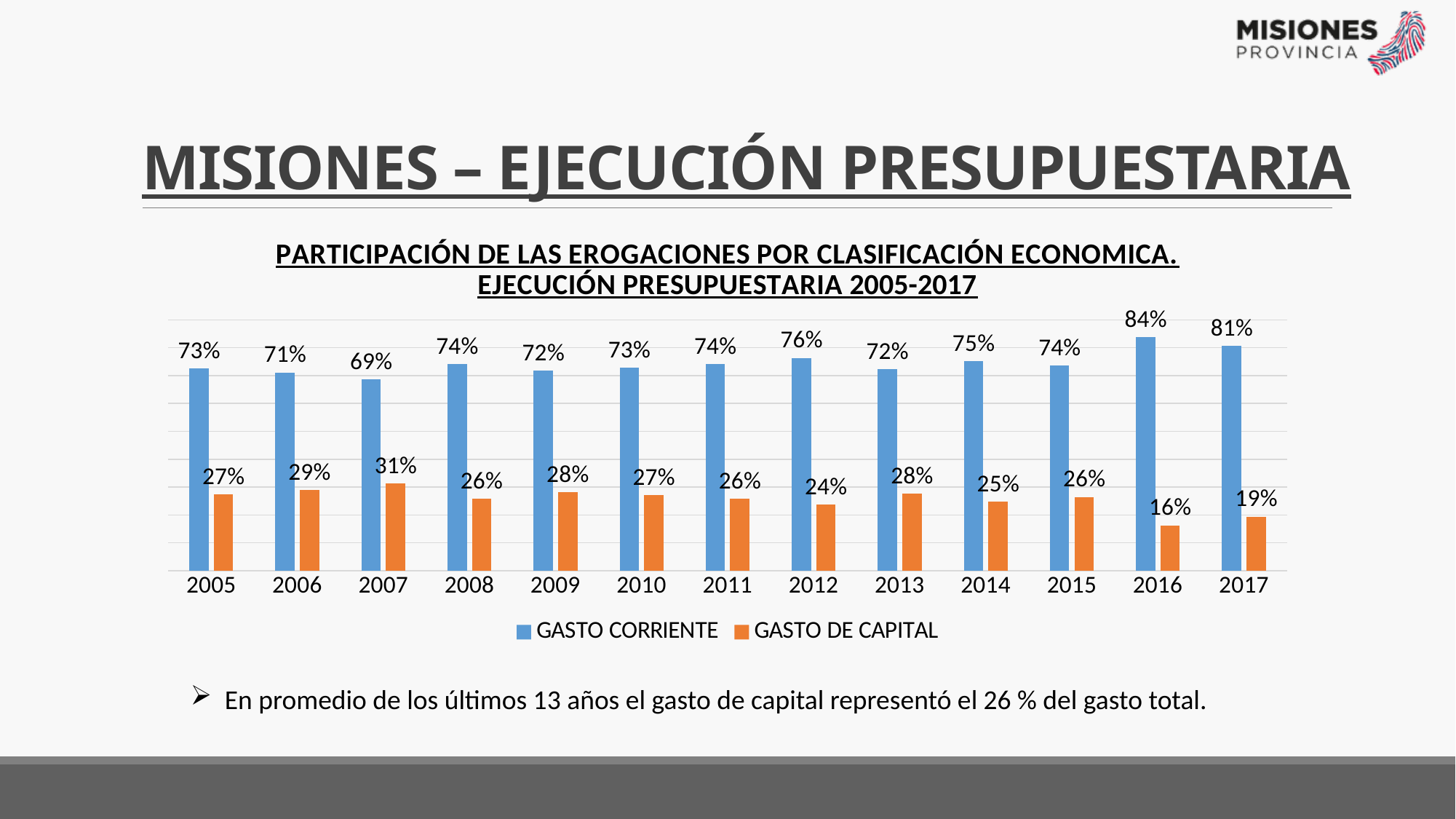
In which year is GASTO DE CAPITAL lowest? 2016 Which is larger: GASTO DE CAPITAL in 2006 or GASTO DE CAPITAL in 2014? GASTO DE CAPITAL in 2006 What is the value for GASTO DE CAPITAL in 2012? 24% How many series does the legend list? 2 How many years are shown on the x axis? 13 What is the value for GASTO CORRIENTE in 2016? 84% In which year is GASTO CORRIENTE highest? 2016 What is the difference between GASTO CORRIENTE and GASTO DE CAPITAL in 2017? 62% What kind of chart is shown on the slide? Bar chart What is the value for GASTO DE CAPITAL in 2007? 31% In which year is GASTO CORRIENTE lowest? 2007 Which colour represents GASTO DE CAPITAL in the chart? Orange